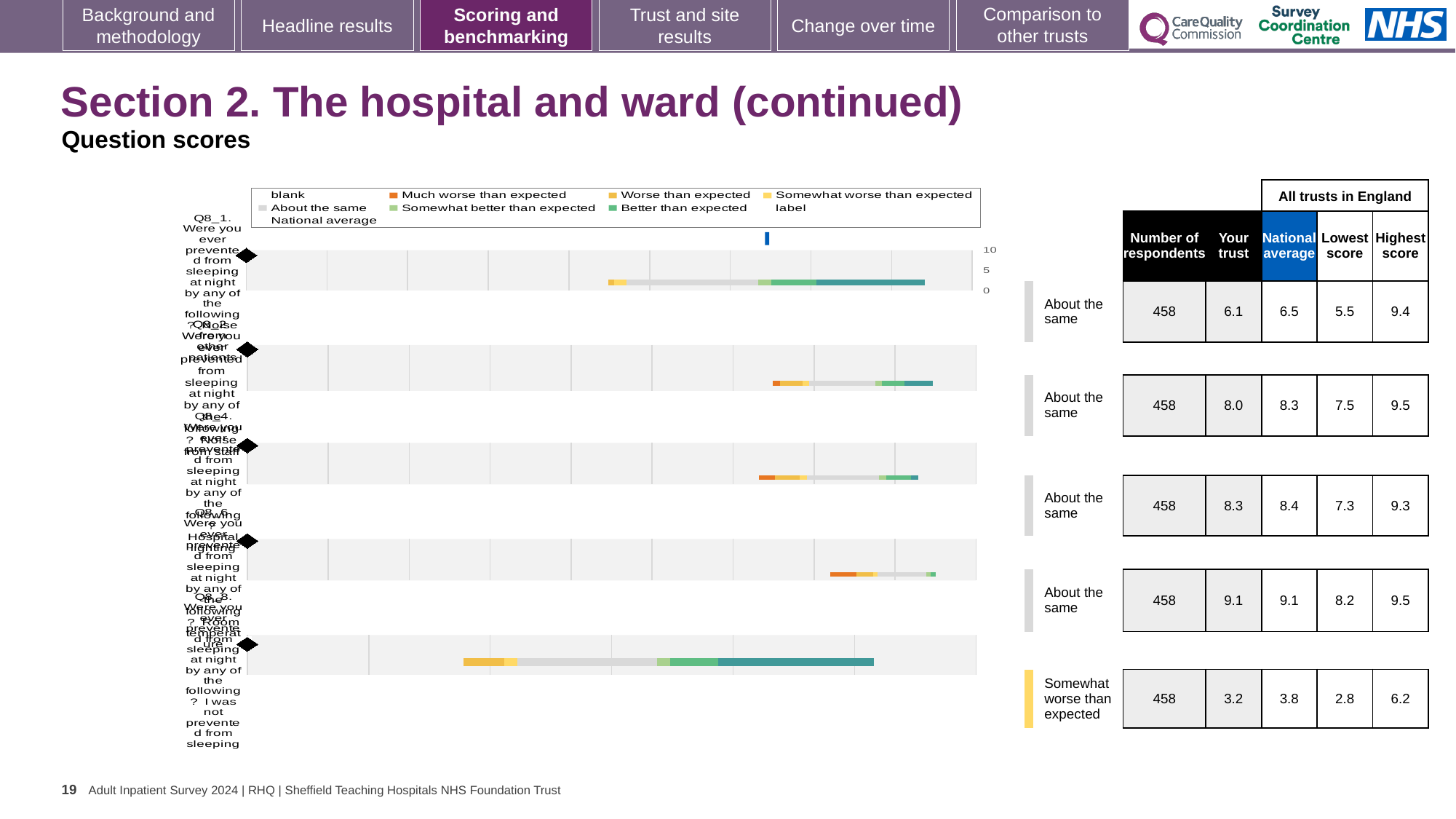
Which row has the highest 'Your trust' score in the table beside the chart? Q8_6 (fourth row), 9.1 What benchmark label is given to the last row (Q8_8) of the chart? Somewhat worse than expected For the last row (Q8_8), what is the difference between the national average and the 'Your trust' score? 0.6 In the table beside the chart, what is the highest score for the second row (Q8_2)? 9.5 How many respondents are listed for each row in the table beside the chart? 458 In the table beside the chart, what is the 'Your trust' score for the first row (Q8_1)? 6.1 In the table beside the chart, what is the national average for the last row (Q8_8)? 3.8 For the first row (Q8_1), which is larger: the 'Your trust' score or the national average? national average Which row has the lowest 'Your trust' score in the table beside the chart? Q8_8 (fifth row), 3.2 What kind of chart is shown on the slide? bar chart How many question rows (bars) does the chart show? 5 In the table beside the chart, what is the lowest score for the third row (Q8_4)? 7.3